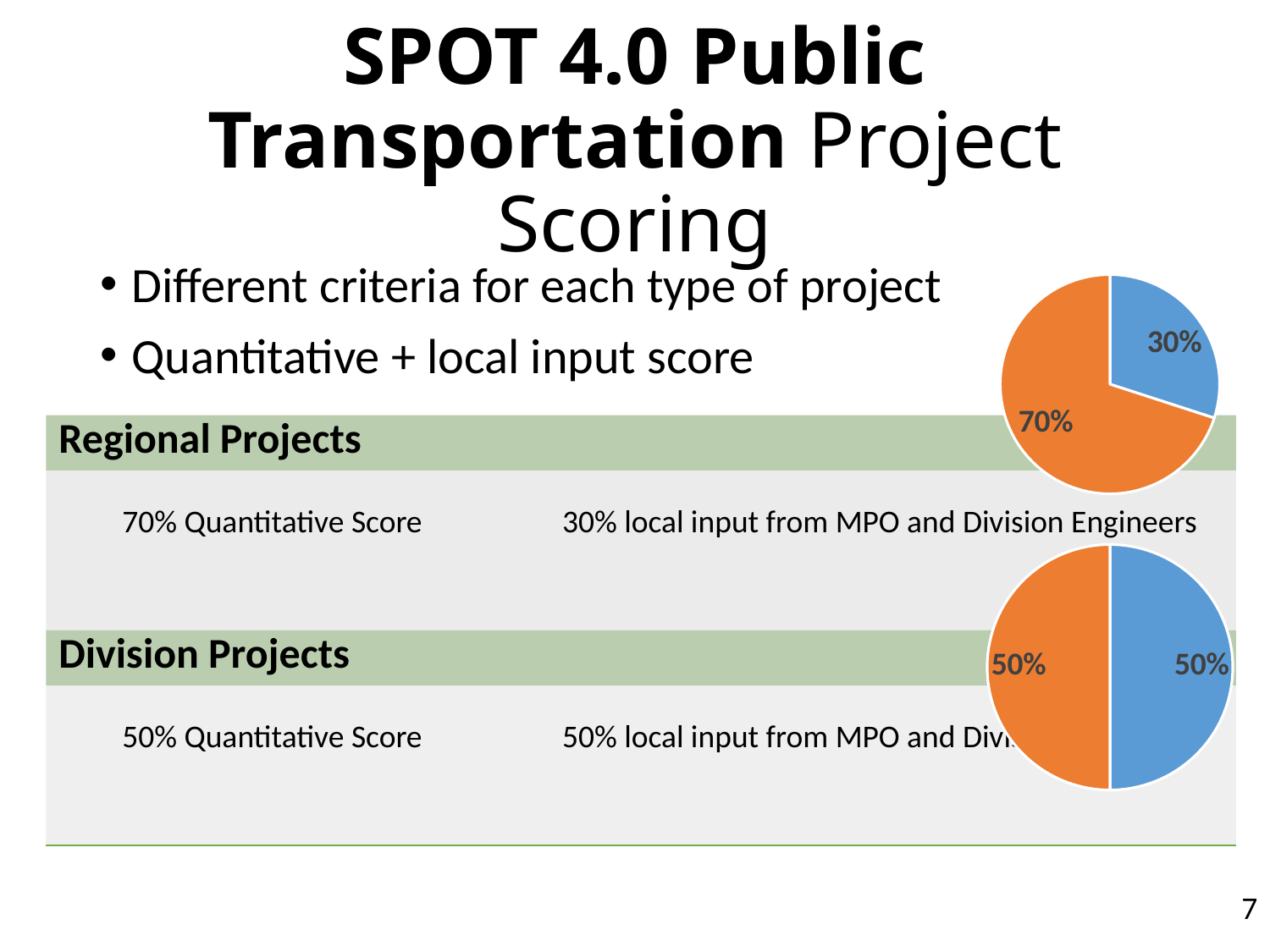
In the lower pie chart, what value is shown on the blue slice? 50% What two colours are used for the slices in the upper pie chart? blue and orange In the lower pie chart, what value is shown on the orange slice? 50% In the upper pie chart, which slice is larger, the blue or the orange one? orange How many slices does the lower pie chart have? 2 In the upper pie chart, what value is shown on the orange slice? 70% How many slices does the upper pie chart have? 2 In the upper pie chart, what is the difference between the orange slice and the blue slice? 40% What kind of chart is the upper chart on the right side of the slide? pie chart In the lower pie chart, what is the difference between the orange slice and the blue slice? 0% What kind of chart is the lower chart on the right side of the slide? pie chart In the upper pie chart, what value is shown on the blue slice? 30%